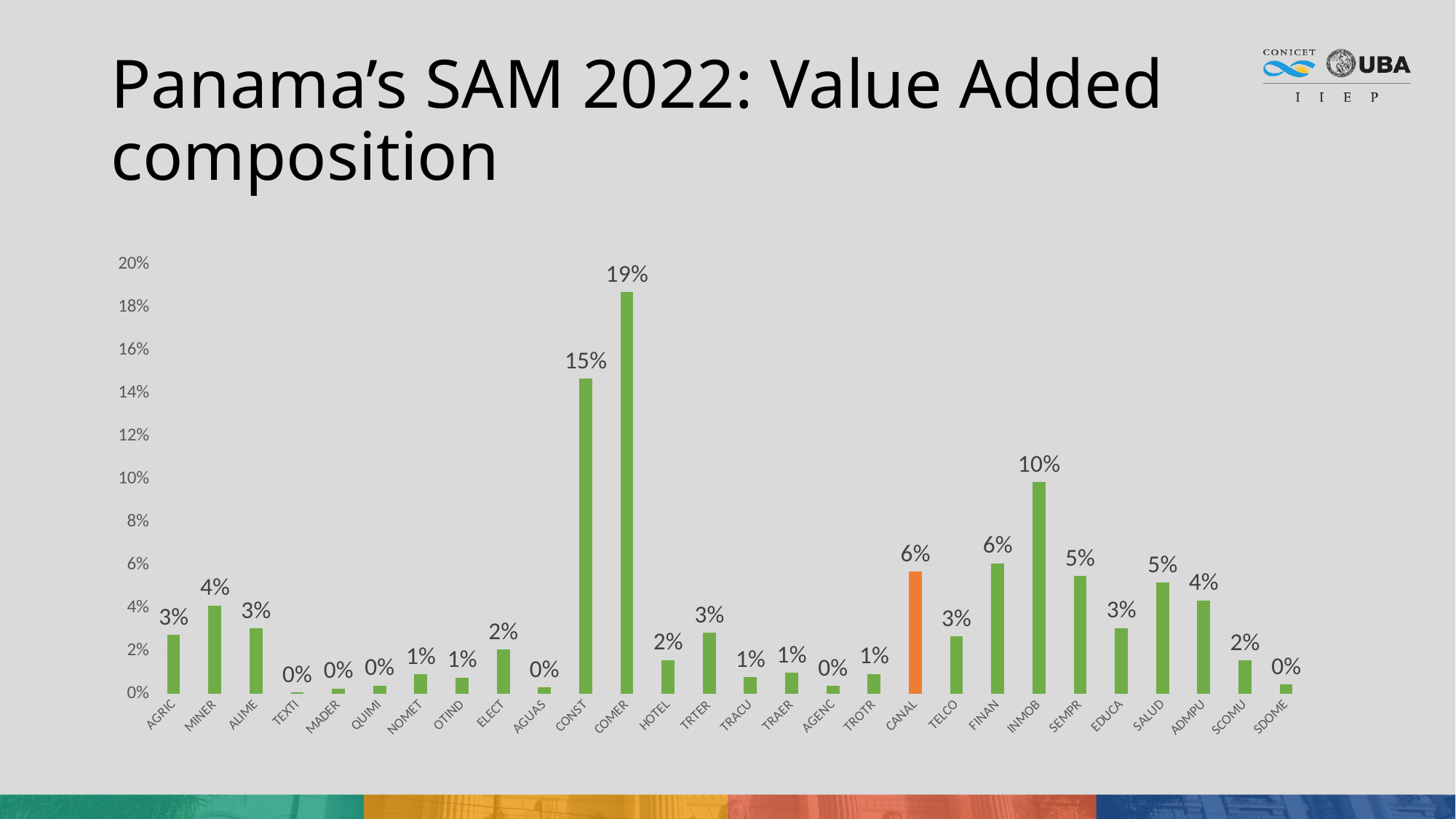
Which category has the highest value? COMER What is the value for INMOB? 10% Which category's bar is coloured orange instead of green? CANAL What is the value for CONST? 15% What is the value for CANAL? 6% Is the value for COMER greater or less than 18%? greater How many categories are shown on the x axis? 28 Which is larger, the value for CONST or the value for INMOB? CONST Which is larger, the value for CANAL or the value for TELCO? CANAL What is the difference between the values for COMER and CONST? 4% What is the value for COMER? 19% What kind of chart is shown on the slide? bar chart